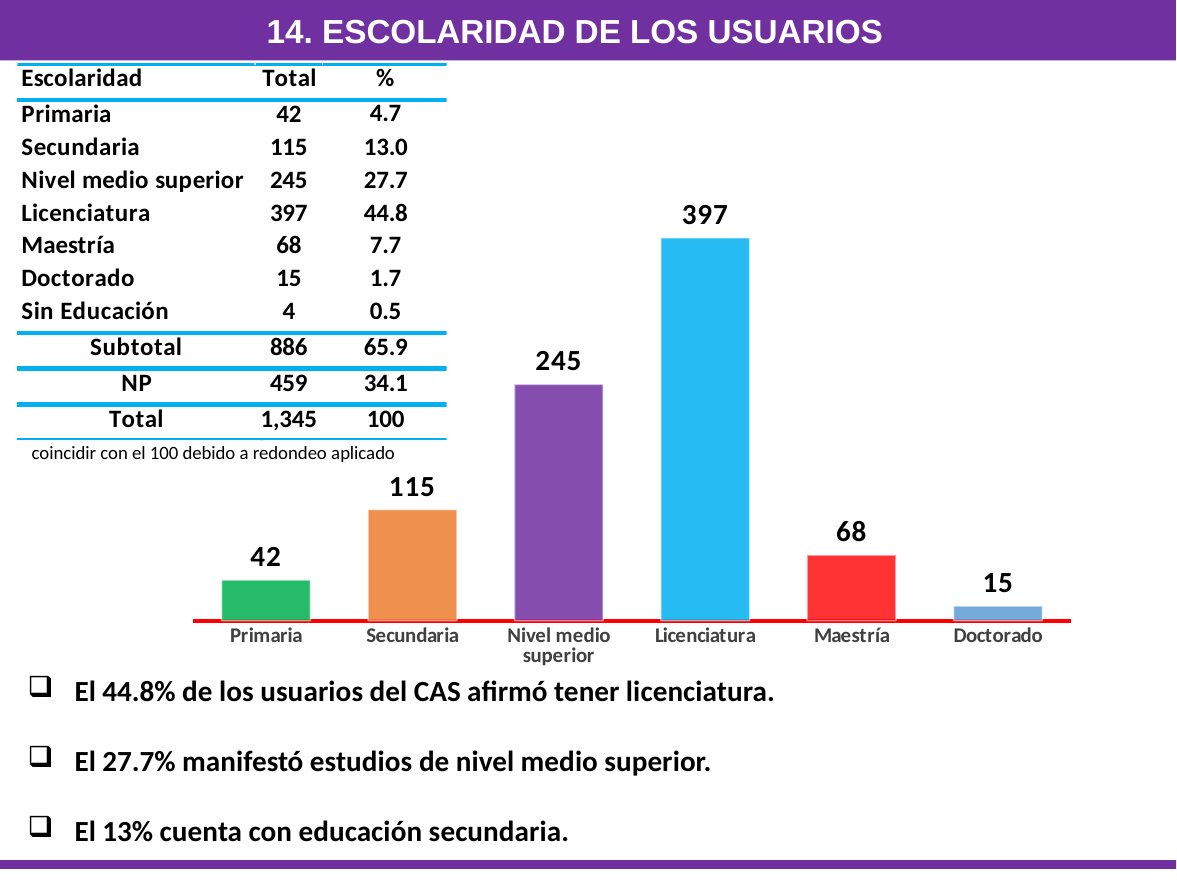
What is the value of the bar for Maestría? 68 What kind of chart is shown on the slide? Bar chart Which is larger, the value for Secundaria or the value for Maestría? Secundaria What is the value of the bar for Secundaria? 115 What is the value of the bar for Doctorado? 15 How many categories are shown on the x axis of the chart? 6 What colour is the bar for Nivel medio superior? Purple What is the difference between the values for Licenciatura and Nivel medio superior? 152 Which category has the highest bar? Licenciatura What is the value of the bar for Licenciatura? 397 Which category has the lowest bar? Doctorado What is the difference between the values for Maestría and Primaria? 26